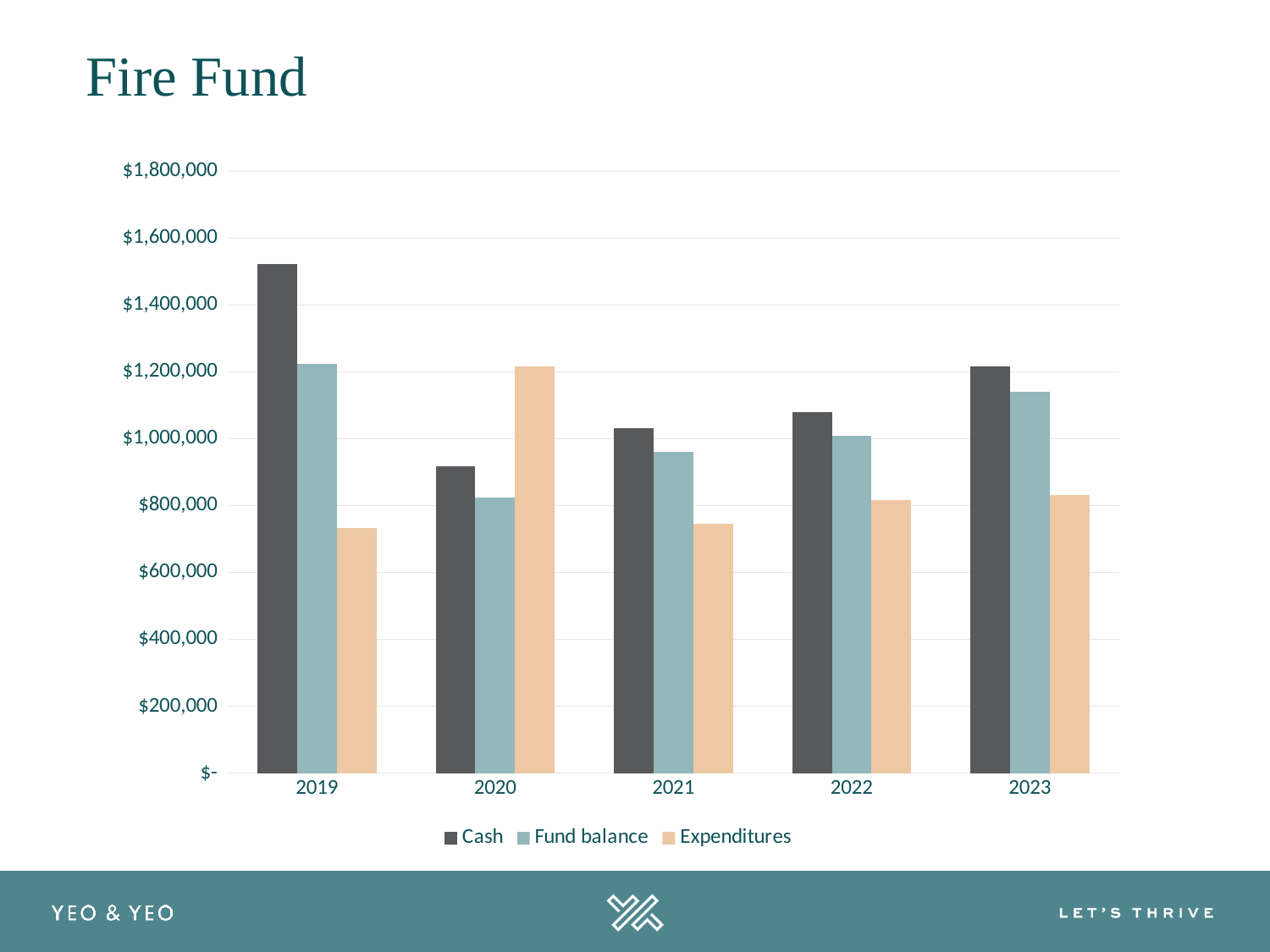
In which year is Fund balance lowest? 2020 In which year are Expenditures highest? 2020 Does Cash rise or fall from 2020 to 2023? Rise In 2020, which is larger: Cash or Expenditures? Expenditures What kind of chart is shown on the slide? Bar chart What is the title of the chart? Fire Fund In which year is Cash highest? 2019 How many years are shown on the x axis? 5 Is the value for Expenditures in 2021 greater or less than $800,000? less How many series does the legend list? 3 Is the value for Cash in 2019 greater or less than $1,400,000? greater In which year is Cash lowest? 2020